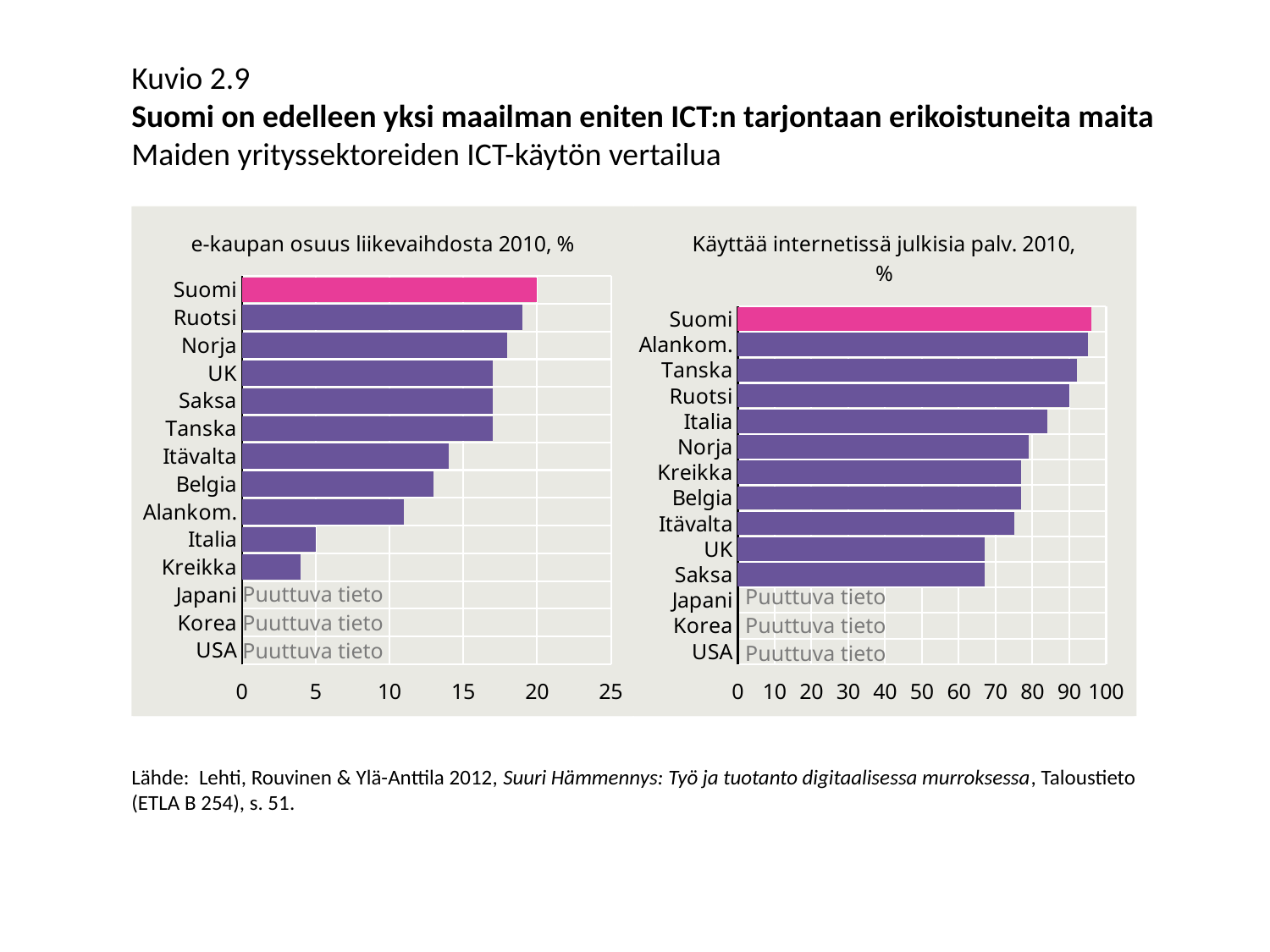
In the left chart 'e-kaupan osuus liikevaihdosta 2010, %', which country with a plotted bar has the lowest value? Kreikka In the left chart 'e-kaupan osuus liikevaihdosta 2010, %', how many countries are marked 'Puuttuva tieto' (missing data)? 3 In the right chart 'Käyttää internetissä julkisia palv. 2010, %', which country has the highest value? Suomi In the left chart 'e-kaupan osuus liikevaihdosta 2010, %', is the value for Belgia greater or less than 10? greater In the right chart 'Käyttää internetissä julkisia palv. 2010, %', is the value for Itävalta greater or less than 80? less How many country categories are listed on the y axis of the right chart 'Käyttää internetissä julkisia palv. 2010, %'? 14 In the left chart 'e-kaupan osuus liikevaihdosta 2010, %', is the value for Itävalta greater or less than 15? less In the left chart 'e-kaupan osuus liikevaihdosta 2010, %', which country has the highest value? Suomi In the right chart 'Käyttää internetissä julkisia palv. 2010, %', which is larger, the value for Alankom. or the value for Italia? Alankom. Which country's bar is highlighted in pink in both charts? Suomi What kind of chart is the left chart, 'e-kaupan osuus liikevaihdosta 2010, %'? bar chart In the left chart 'e-kaupan osuus liikevaihdosta 2010, %', which is larger, the value for Ruotsi or the value for UK? Ruotsi